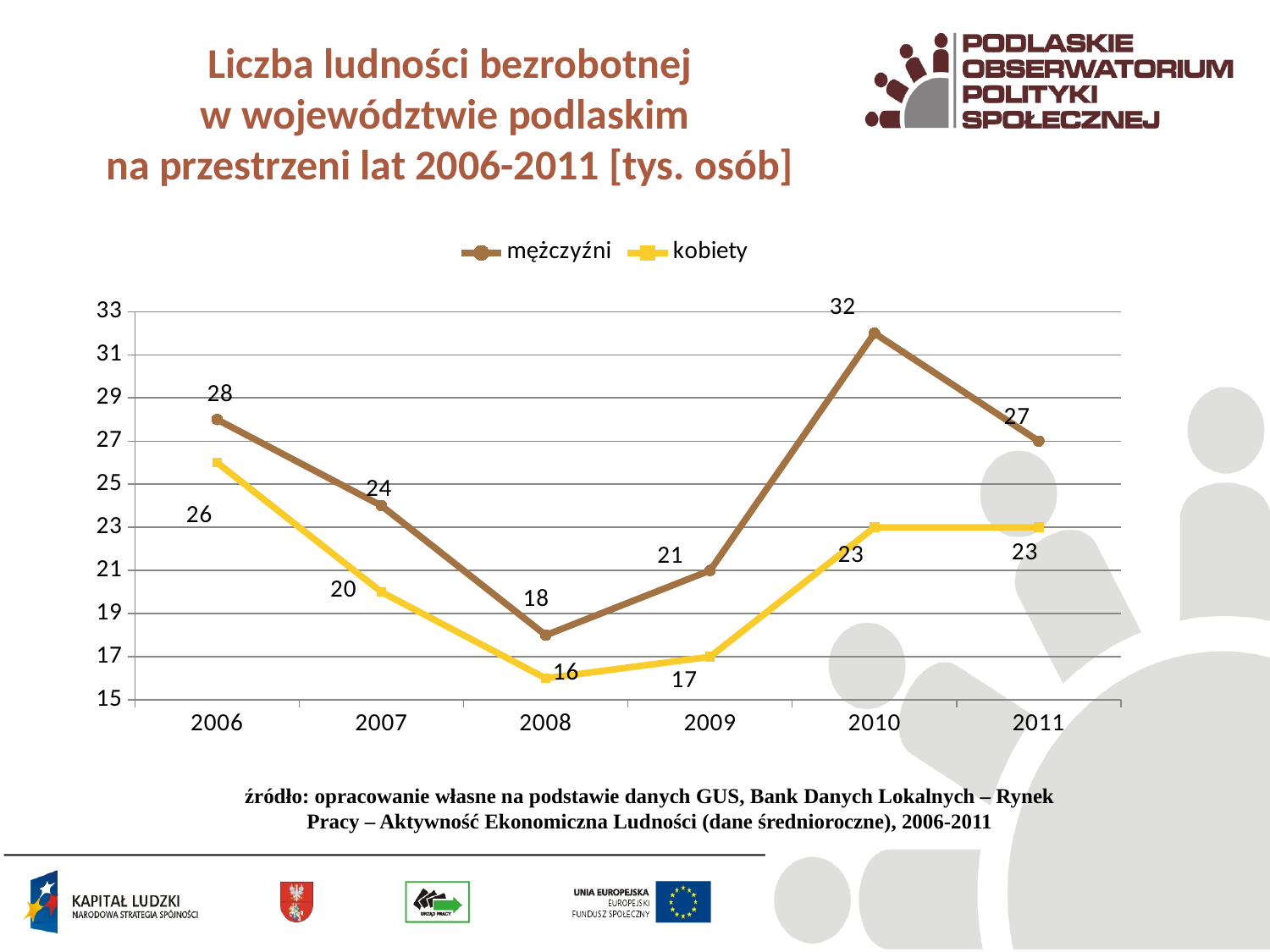
What is the difference between mężczyźni and kobiety in 2010? 9 What type of chart is shown on the slide? line chart Does the value for mężczyźni rise or fall from 2006 to 2008? fall In which year is the value for mężczyźni highest? 2010 In which year is the value for kobiety lowest? 2008 Which is larger in 2007: mężczyźni or kobiety? mężczyźni What is the value for kobiety in 2008? 16 How many years are shown on the x axis? 6 How many series does the legend list? 2 What is the value for kobiety in 2006? 26 Which series is drawn in yellow? kobiety What is the value for mężczyźni in 2010? 32